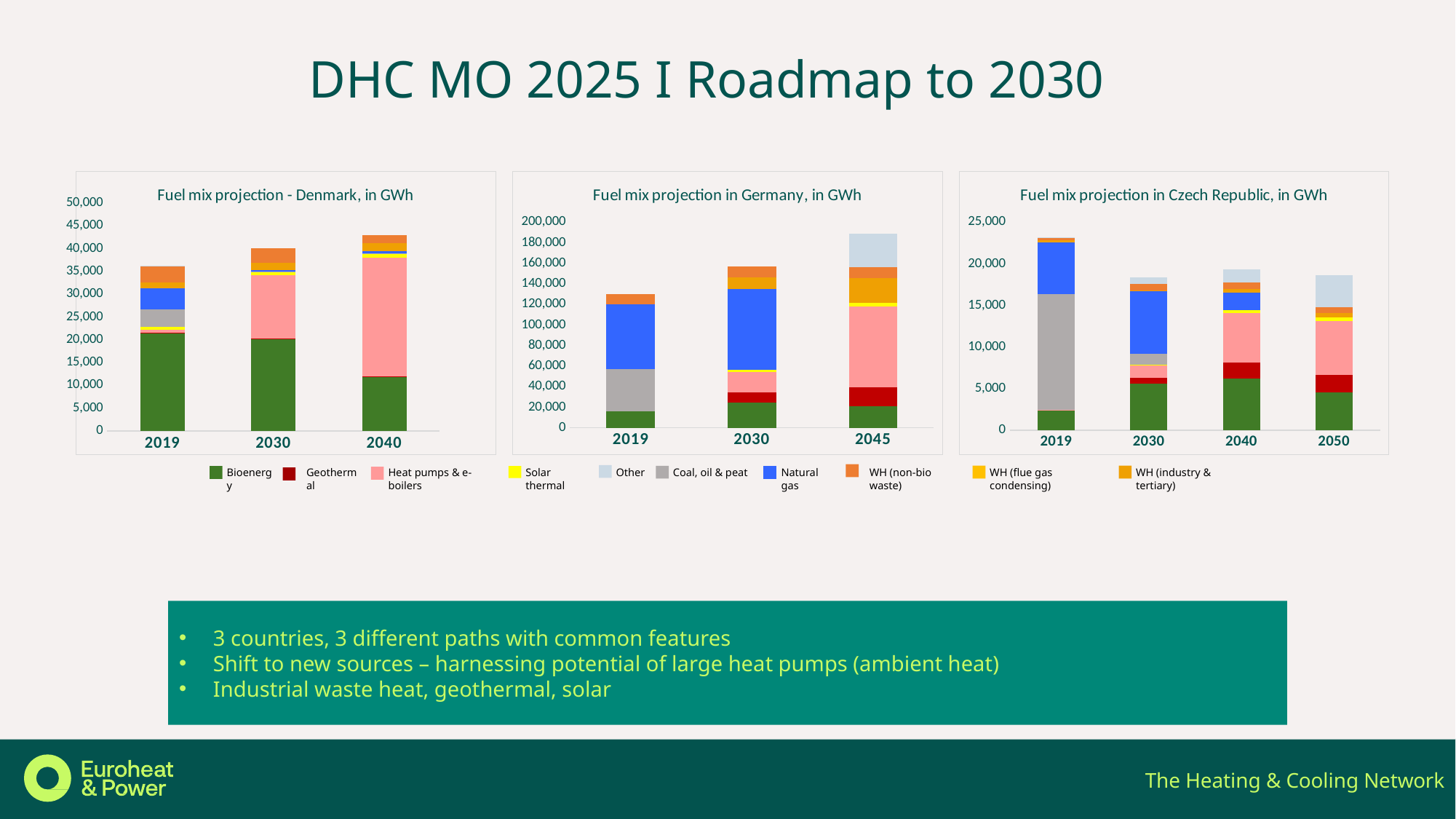
In the 'Fuel mix projection in Czech Republic, in GWh' chart, is the total for 2030 greater or less than 20,000? less How many years (bars) are shown in the 'Fuel mix projection in Czech Republic, in GWh' chart? 4 In the 'Fuel mix projection in Germany, in GWh' chart, is the total for 2019 greater or less than 140,000? less In the 'Fuel mix projection in Germany, in GWh' chart, which year has the highest total bar? 2045 In the 'Fuel mix projection - Denmark, in GWh' chart, is the total for 2040 greater or less than 40,000? greater How many series does the shared legend below the three charts list? 10 What kind of chart is the 'Fuel mix projection - Denmark, in GWh' chart? stacked bar chart In the 'Fuel mix projection - Denmark, in GWh' chart, which year has the highest total bar? 2040 What is the highest value shown on the vertical axis of the 'Fuel mix projection in Germany, in GWh' chart? 200,000 In the 'Fuel mix projection in Czech Republic, in GWh' chart, which year has the highest total bar? 2019 In the 'Fuel mix projection in Germany, in GWh' chart, do the total bar heights rise or fall from 2019 to 2045? rise How many years (bars) are shown in the 'Fuel mix projection - Denmark, in GWh' chart? 3